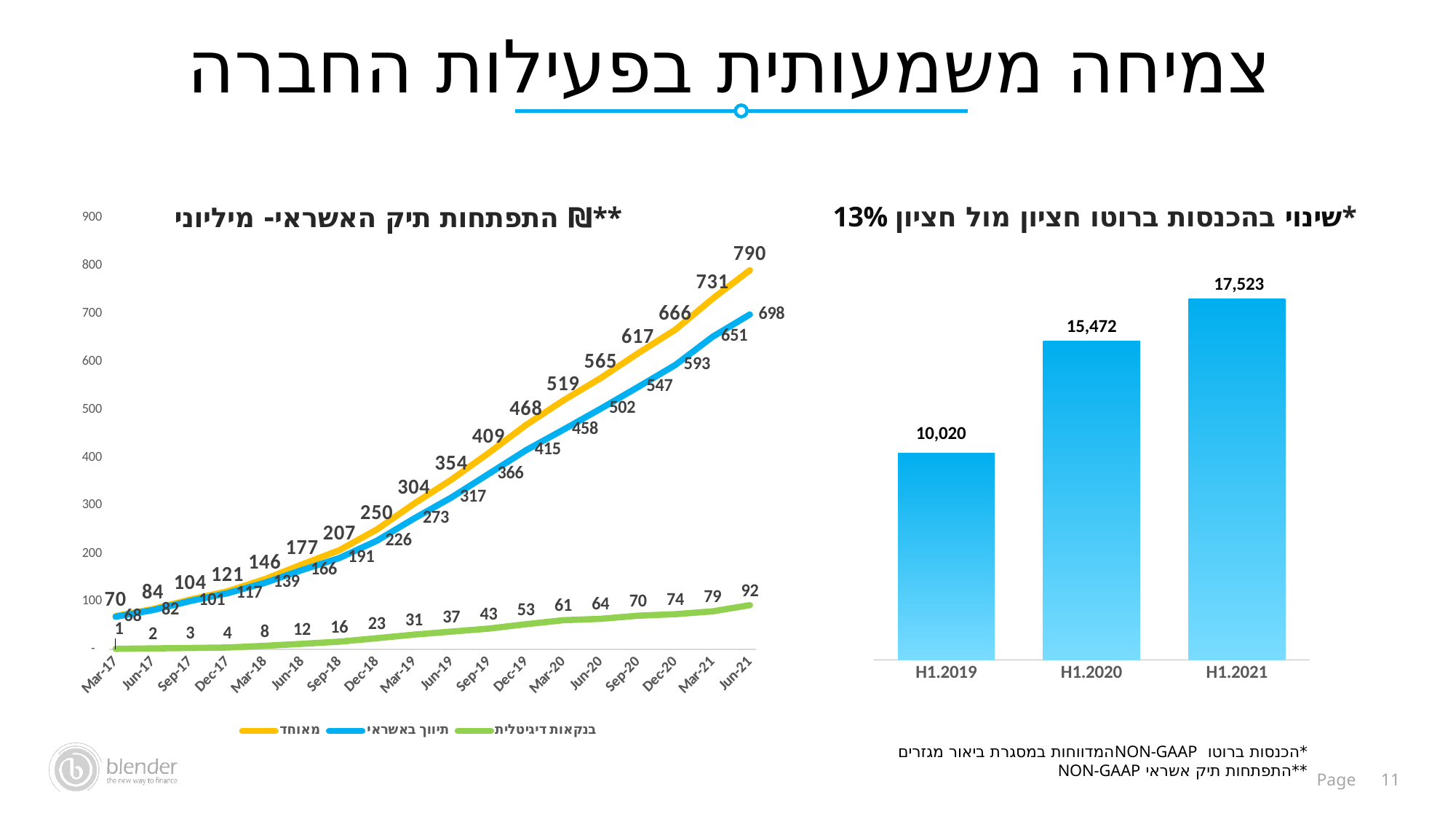
In the bar chart on the right, do the values rise or fall from H1.2019 to H1.2021? rise In the bar chart on the right, what is the value for H1.2021? 17,523 What kind of chart is the chart on the left? line chart In the line chart on the left, what is the value of the מאוחד series at Jun-21? 790 In the bar chart on the right, what is the value for H1.2019? 10,020 In the bar chart on the right, what is the difference between the H1.2021 and H1.2020 values? 2,051 In the line chart on the left, which series has the highest value at Jun-21? מאוחד In the bar chart on the right, which half-year has the lowest value? H1.2019 In the line chart on the left, what is the difference between the מאוחד and תיווך באשראי values at Jun-21? 92 How many bars are in the bar chart on the right? 3 In the line chart on the left, what is the value of the בנקאות דיגיטלית series at Mar-20? 61 How many series does the legend of the line chart on the left list? 3